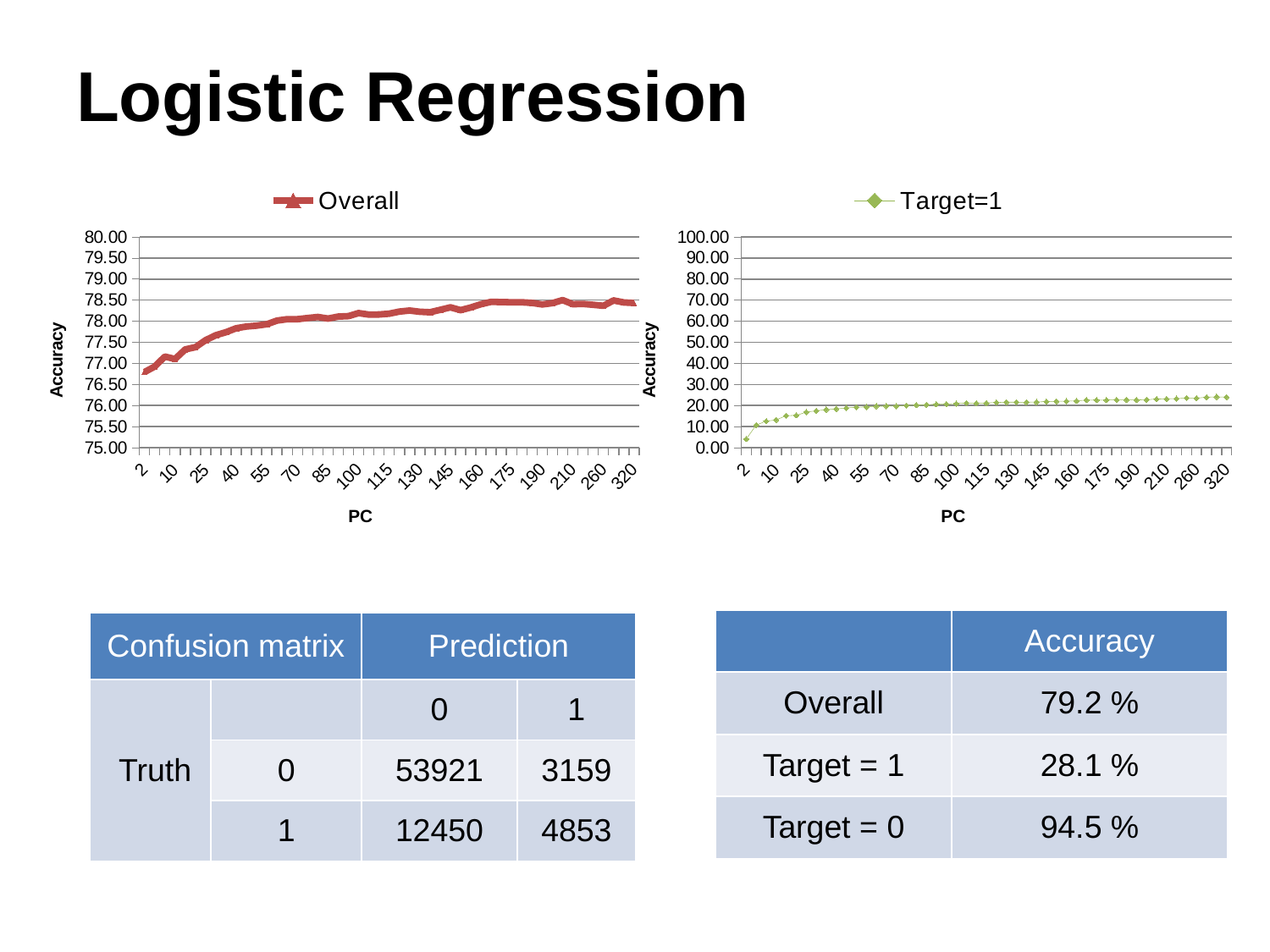
What kind of chart is the Target=1 chart on the right? line chart How many series does the legend of the Target=1 chart list? 1 How many series does the legend of the Overall chart list? 1 In the Overall chart, do the values generally rise or fall as PC increases along the x axis? rise In the Overall chart, is the value at PC=320 greater or less than 78.00? greater In the Overall chart, is the value at PC=2 greater or less than 77.00? less In the Target=1 chart, is the value at PC=320 greater or less than 30.00? less In the Target=1 chart, do the values generally rise or fall as PC increases along the x axis? rise What kind of chart is the Overall chart on the left? line chart What is the label of the y axis on the Target=1 chart? Accuracy What is the label of the x axis on the Overall chart? PC